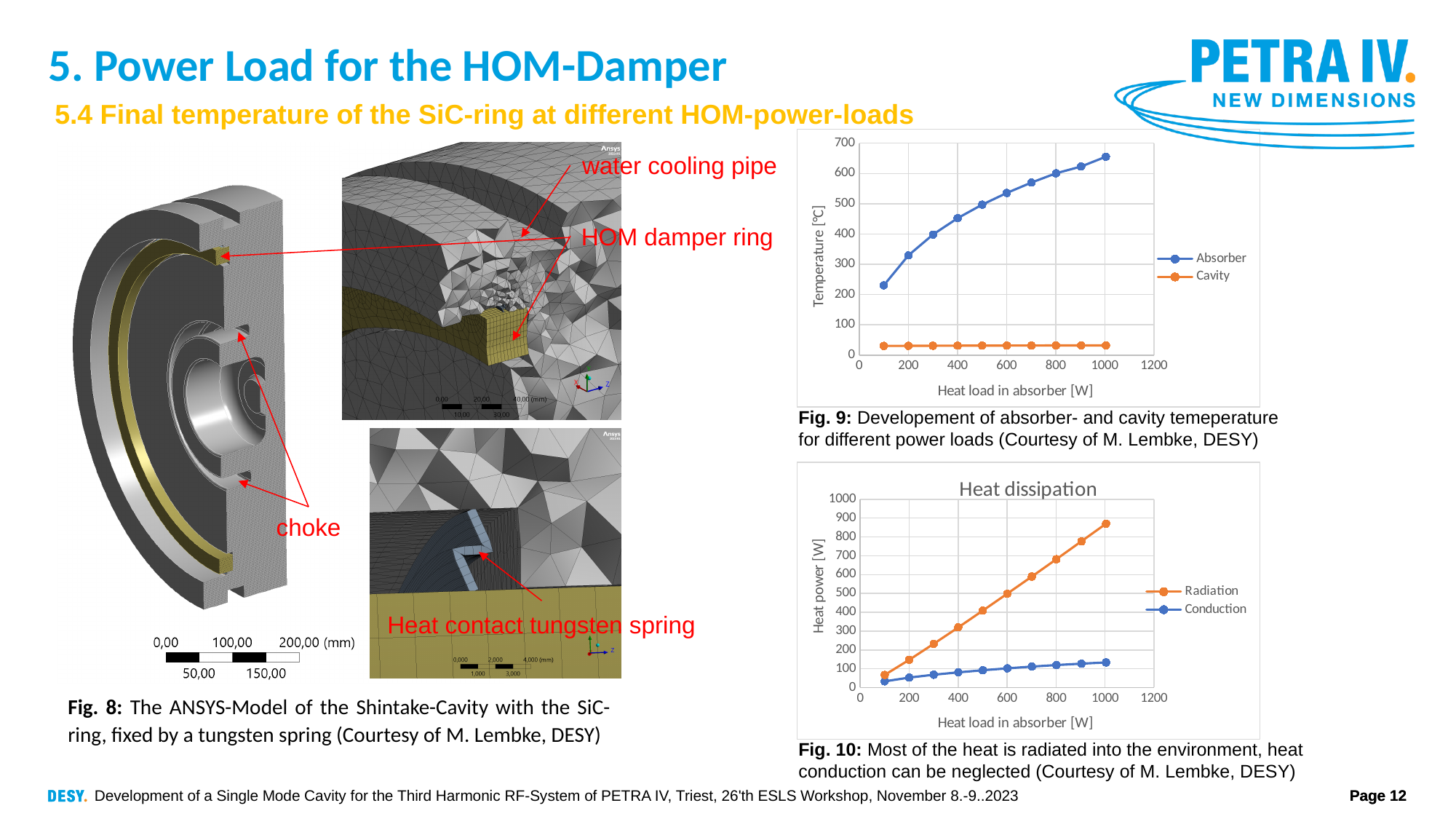
In the Heat dissipation chart, is the Radiation value at a heat load of 1000 W greater or less than 800? greater What kind of chart is the Heat dissipation chart? line chart In the top-right chart (Fig. 9), is the Absorber temperature at a heat load of 1000 W greater or less than 600? greater In the top-right chart (Fig. 9), how many data points are plotted for the Absorber series? 10 In the top-right chart (Fig. 9), which series has the higher temperature at a heat load of 800 W, Absorber or Cavity? Absorber In the top-right chart (Fig. 9), how many series does the legend list? 2 In the top-right chart (Fig. 9), what are the two series named in the legend? Absorber and Cavity In the top-right chart (Fig. 9), does the Absorber temperature rise or fall as the heat load increases? rise In the top-right chart (Fig. 9), is the Cavity temperature at a heat load of 500 W greater or less than 100? less What is the title of the bottom-right chart? Heat dissipation In the Heat dissipation chart, which series is larger at a heat load of 600 W, Radiation or Conduction? Radiation